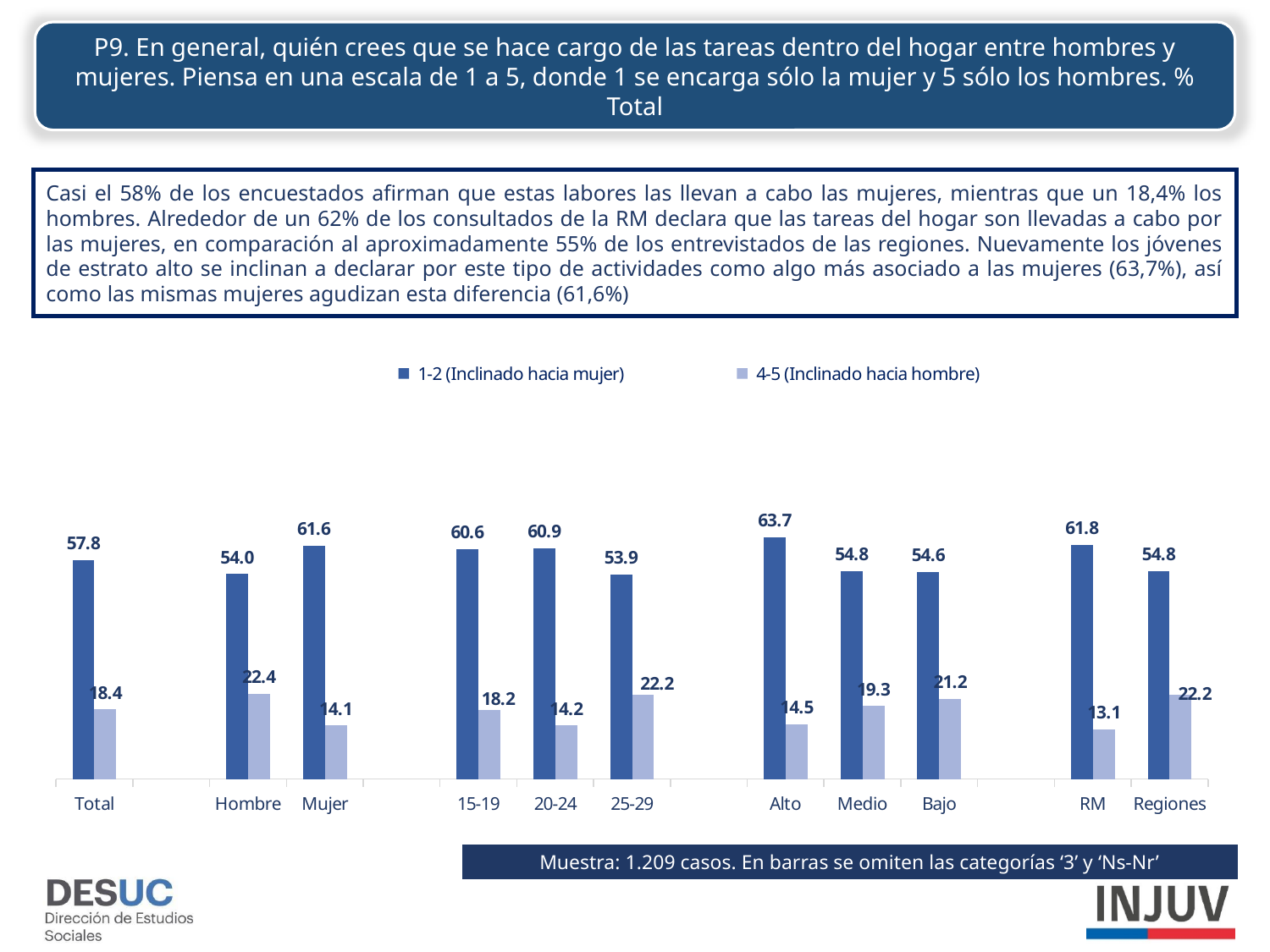
What is the value of '1-2 (Inclinado hacia mujer)' for Total? 57.8 Which legend entry is shown in the darker blue colour? 1-2 (Inclinado hacia mujer) Which category has the highest value for '1-2 (Inclinado hacia mujer)'? Alto What is the difference between the '1-2 (Inclinado hacia mujer)' values for RM and Regiones? 7.0 What type of chart is shown on the slide? bar chart How many series does the legend list? 2 What is the value of '4-5 (Inclinado hacia hombre)' for Bajo? 21.2 What is the value of '4-5 (Inclinado hacia hombre)' for Hombre? 22.4 Which is larger for '1-2 (Inclinado hacia mujer)': Mujer or Hombre? Mujer How many categories are shown along the x axis of the chart? 11 Which category has the lowest value for '4-5 (Inclinado hacia hombre)'? RM What is the value of '1-2 (Inclinado hacia mujer)' for RM? 61.8